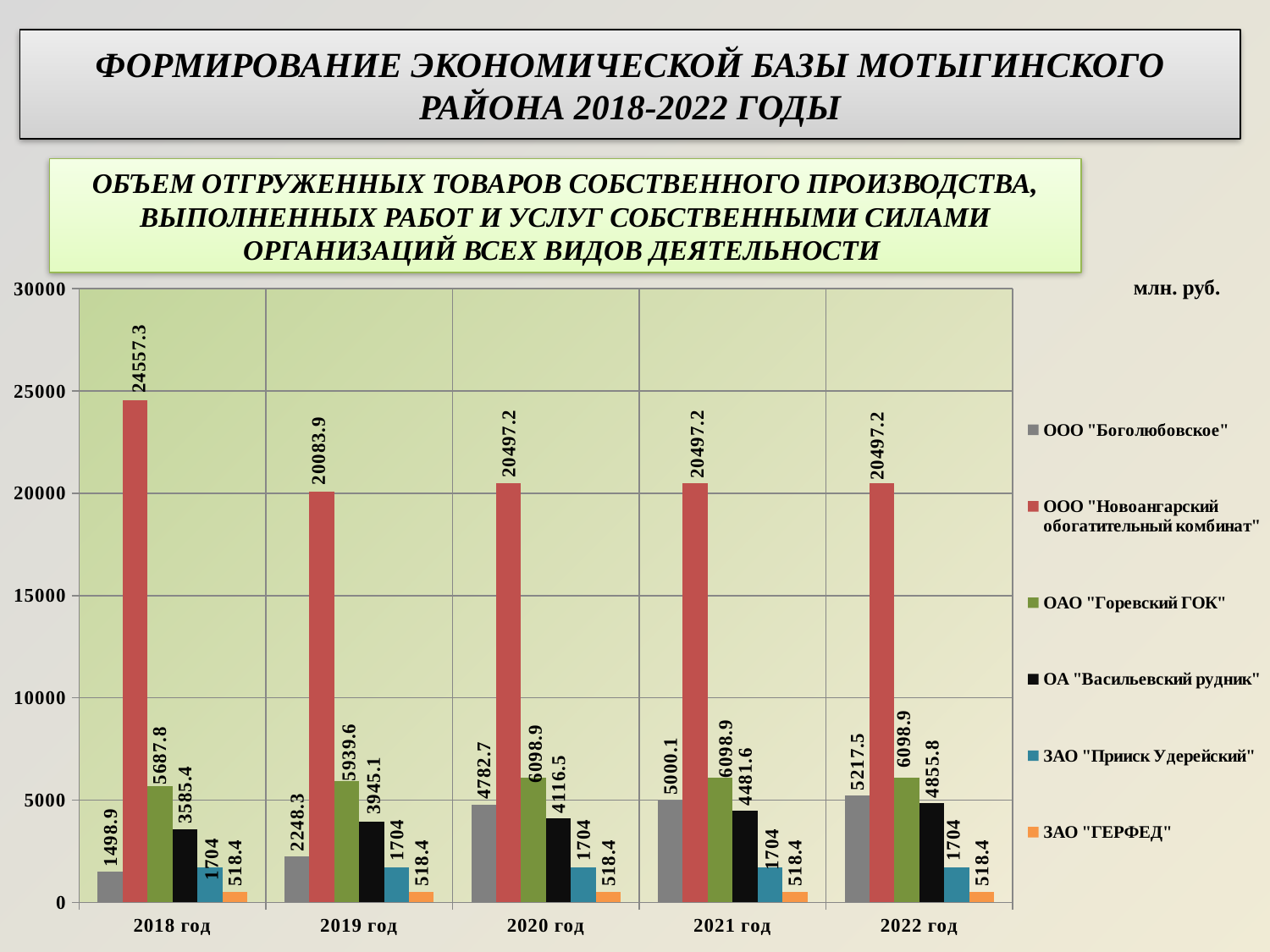
What is the difference between the values for ООО "Боголюбовское" in 2019 год and 2018 год? 749.4 What type of chart is shown on the slide? bar chart How many series does the legend list? 6 Which series has the lowest value in 2021 год? ЗАО "ГЕРФЕД" How many year categories are shown on the x axis? 5 In which year is the value for ООО "Новоангарский обогатительный комбинат" the highest? 2018 год Which is larger in 2019 год: ОАО "Горевский ГОК" or ОА "Васильевский рудник"? ОАО "Горевский ГОК" What is the value for ОА "Васильевский рудник" in 2020 год? 4116.5 What is the value for ООО "Боголюбовское" in 2022 год? 5217.5 Do the values for ООО "Боголюбовское" rise or fall from 2018 год to 2022 год? rise What is the value for ООО "Новоангарский обогатительный комбинат" in 2018 год? 24557.3 What unit is indicated next to the chart? млн. руб.